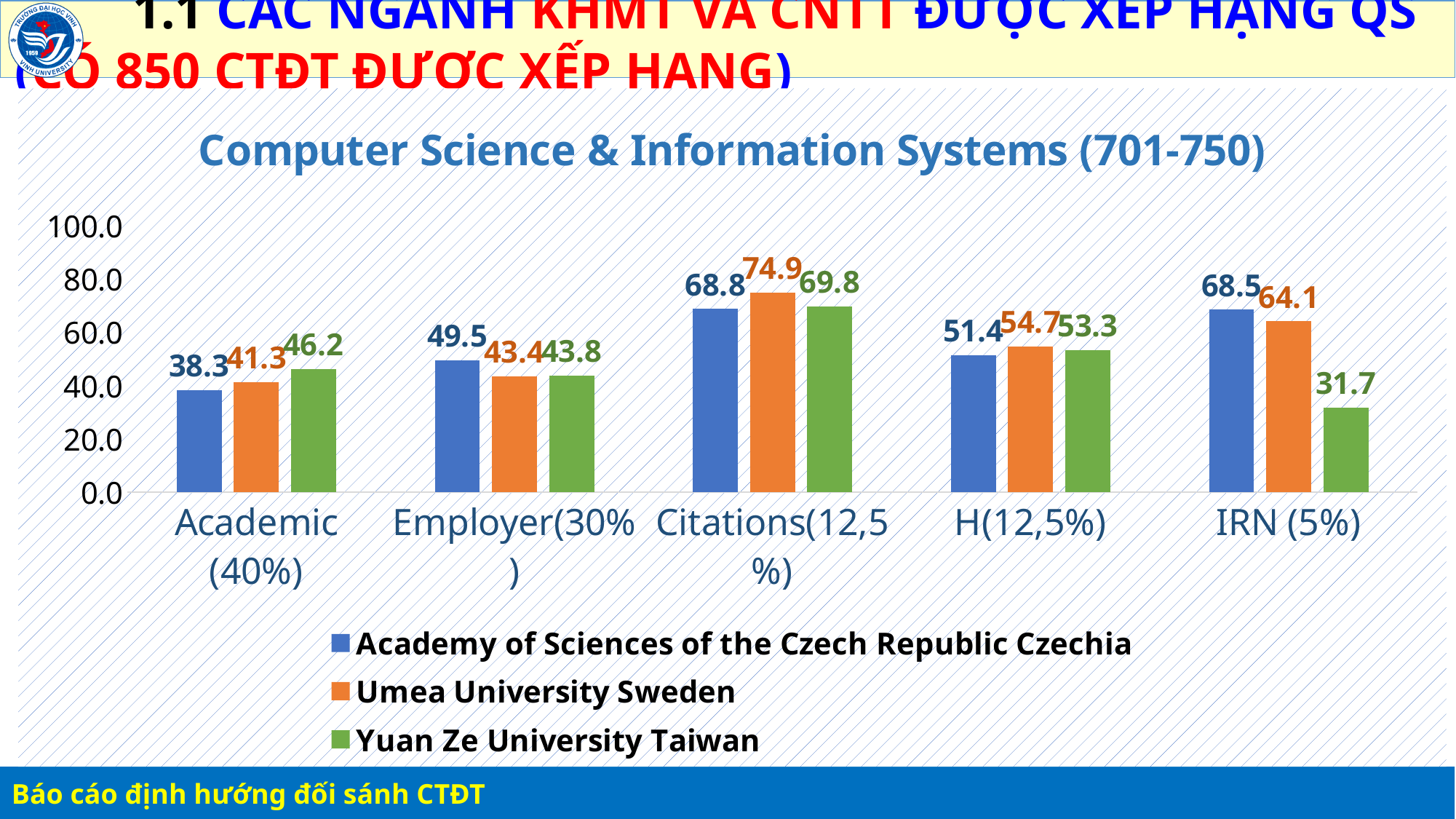
What is the difference between the Academy of Sciences of the Czech Republic Czechia and Yuan Ze University Taiwan values in the IRN (5%) category? 36.8 Which category has the lowest value for Academy of Sciences of the Czech Republic Czechia? Academic (40%) Which category has the highest value for Yuan Ze University Taiwan? Citations(12,5%) How many series does the legend list? 3 What is the value for Umea University Sweden in the Citations(12,5%) category? 74.9 What is the title of the chart? Computer Science & Information Systems (701-750) What is the value for Academy of Sciences of the Czech Republic Czechia in the Academic (40%) category? 38.3 What kind of chart is shown on the slide? bar chart Is the value for Umea University Sweden in the H(12,5%) category greater or less than 60.0? less How many categories are shown on the x axis? 5 In the Employer(30%) category, which is larger: the value for Academy of Sciences of the Czech Republic Czechia or for Umea University Sweden? Academy of Sciences of the Czech Republic Czechia What is the value for Yuan Ze University Taiwan in the IRN (5%) category? 31.7